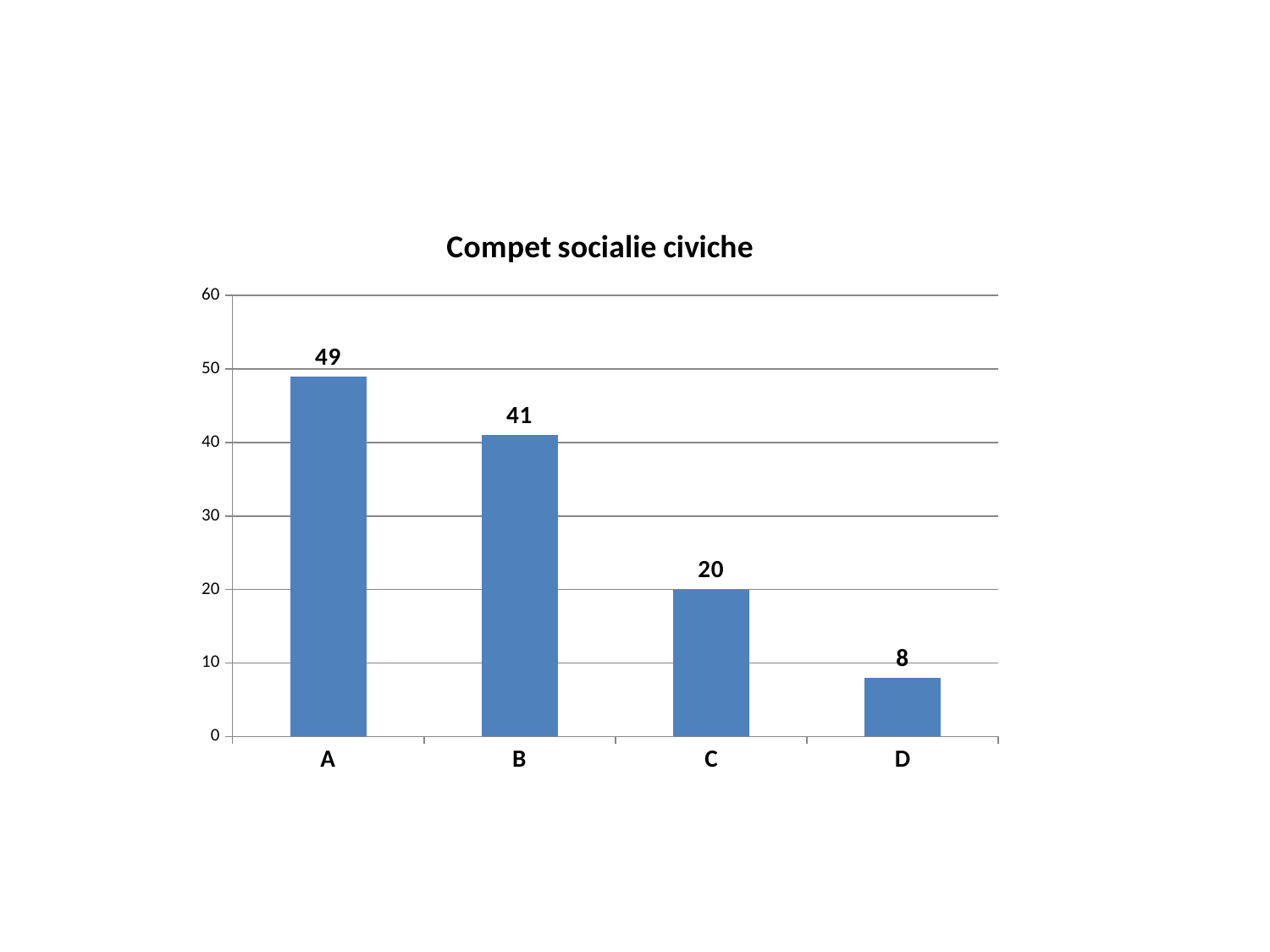
Which category has the highest value? A What is the title of the chart? Compet socialie civiche What is the value for category A? 49 How many categories are shown on the x axis? 4 What is the value for category C? 20 What kind of chart is shown on the slide? bar chart Is the value for B greater or less than 30? greater What is the difference between the values for B and C? 21 What is the difference between the values for A and B? 8 What is the value for category D? 8 Which category has the lowest value? D Which is larger, the value for C or the value for D? C